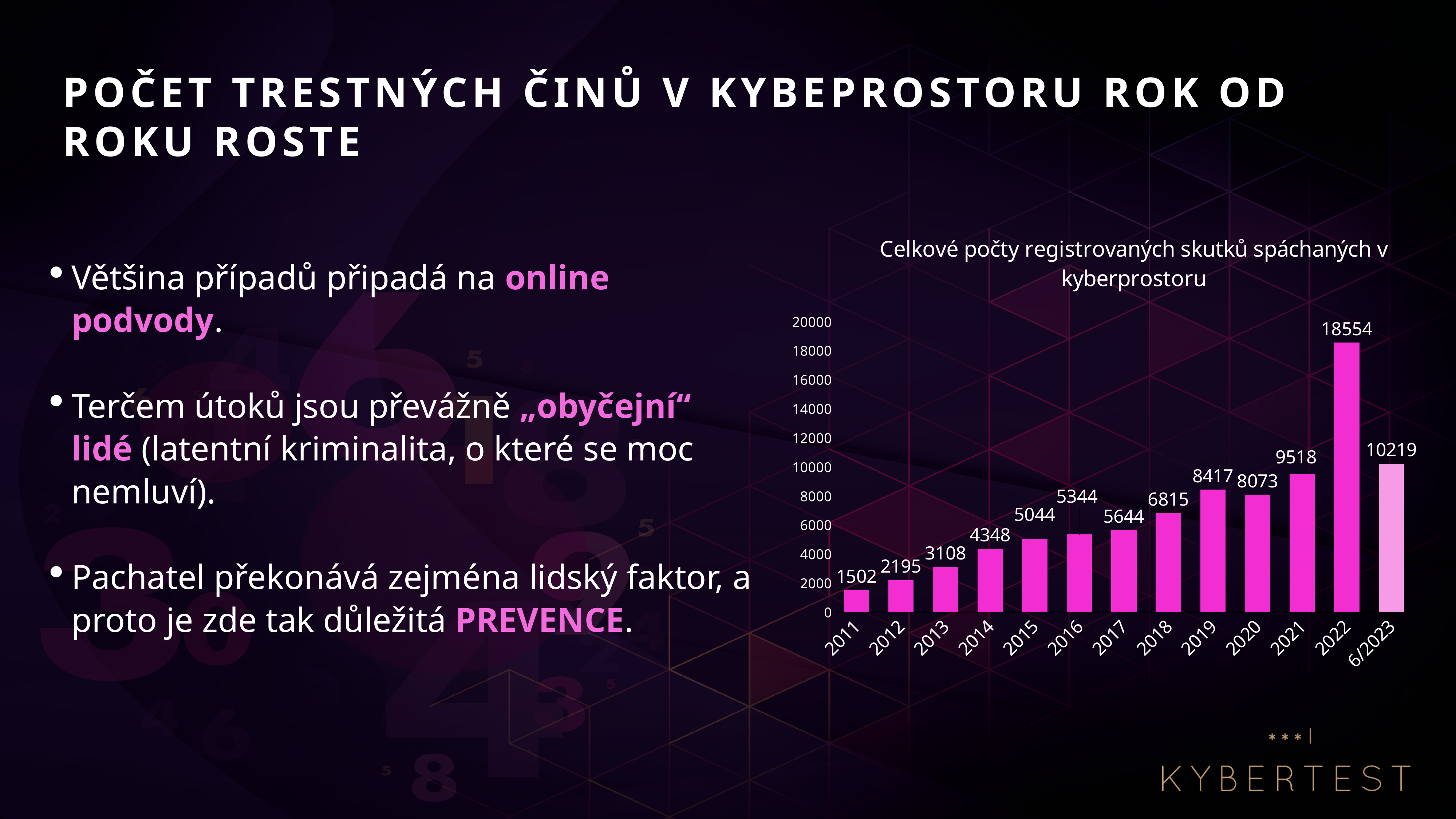
What is the difference between the values for 2016 and 2017? 300 Which category has the lowest value? 2011 What is the value for 6/2023? 10219 How many bars are shown in the chart? 13 What kind of chart is shown on the slide? bar chart Which year has the highest value? 2022 What is the value for 2022? 18554 What is the title of the chart? Celkové počty registrovaných skutků spáchaných v kyberprostoru What is the value for 2011? 1502 What is the difference between the values for 2022 and 2021? 9036 Do the values generally rise or fall from 2011 to 2022? rise Which is larger, the value for 2019 or the value for 2020? 2019